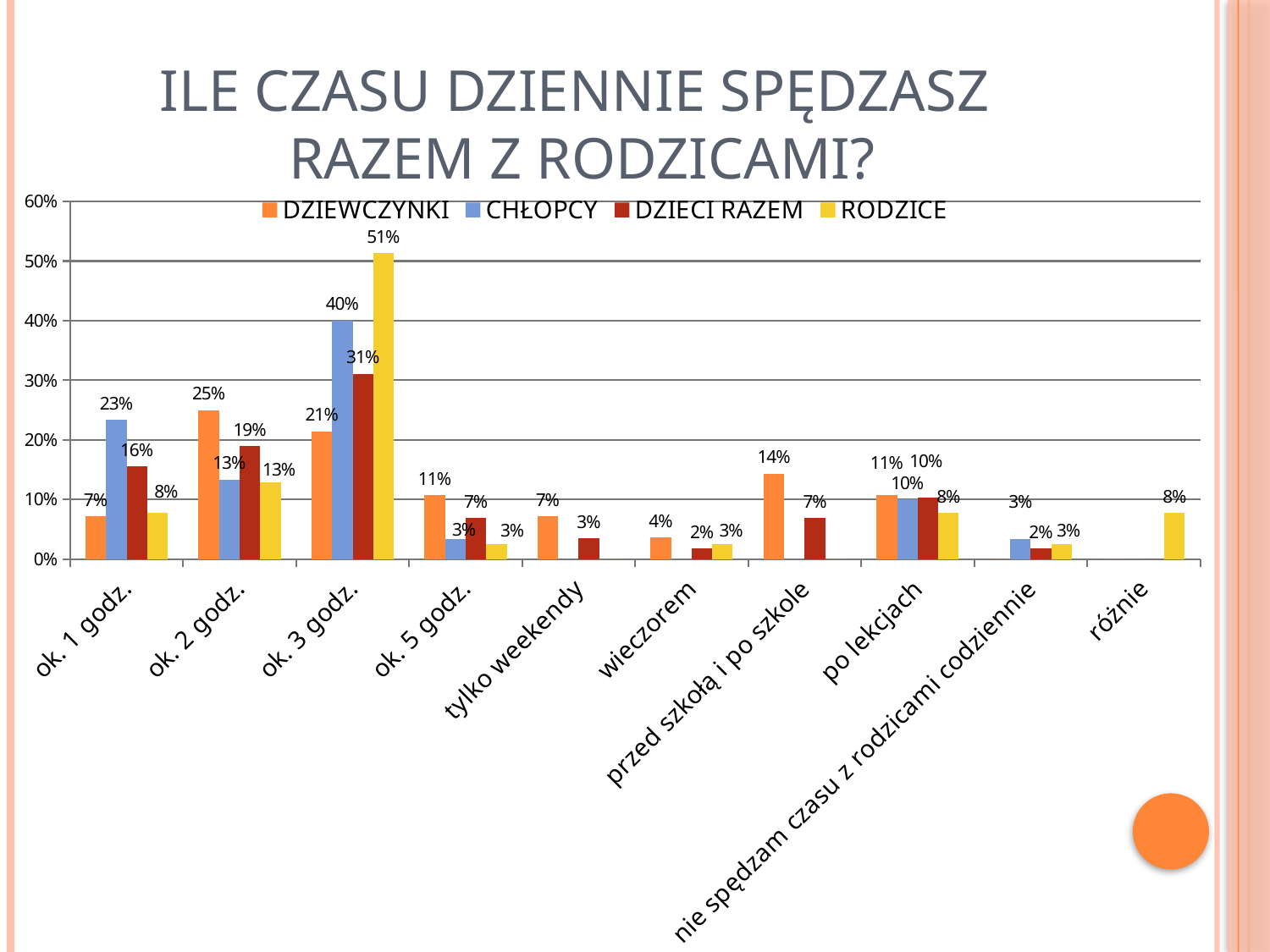
Which category has the highest value for the DZIEWCZYNKI series? ok. 2 godz. What is the difference between the CHŁOPCY and DZIEWCZYNKI values in the 'ok. 3 godz.' category? 19% In the 'ok. 2 godz.' category, which is larger: DZIEWCZYNKI or CHŁOPCY? DZIEWCZYNKI What is the value for DZIEWCZYNKI in the 'przed szkołą i po szkole' category? 14% What kind of chart is shown on the slide? bar chart How many series does the legend list? 4 What is the difference between the RODZICE and DZIECI RAZEM values in the 'ok. 3 godz.' category? 20% What is the value for RODZICE in the 'ok. 3 godz.' category? 51% Which category has the highest value for the RODZICE series? ok. 3 godz. What is the value for CHŁOPCY in the 'ok. 1 godz.' category? 23% How many categories are shown on the x axis? 10 Is the value for CHŁOPCY in the 'ok. 3 godz.' category greater or less than 30%? greater